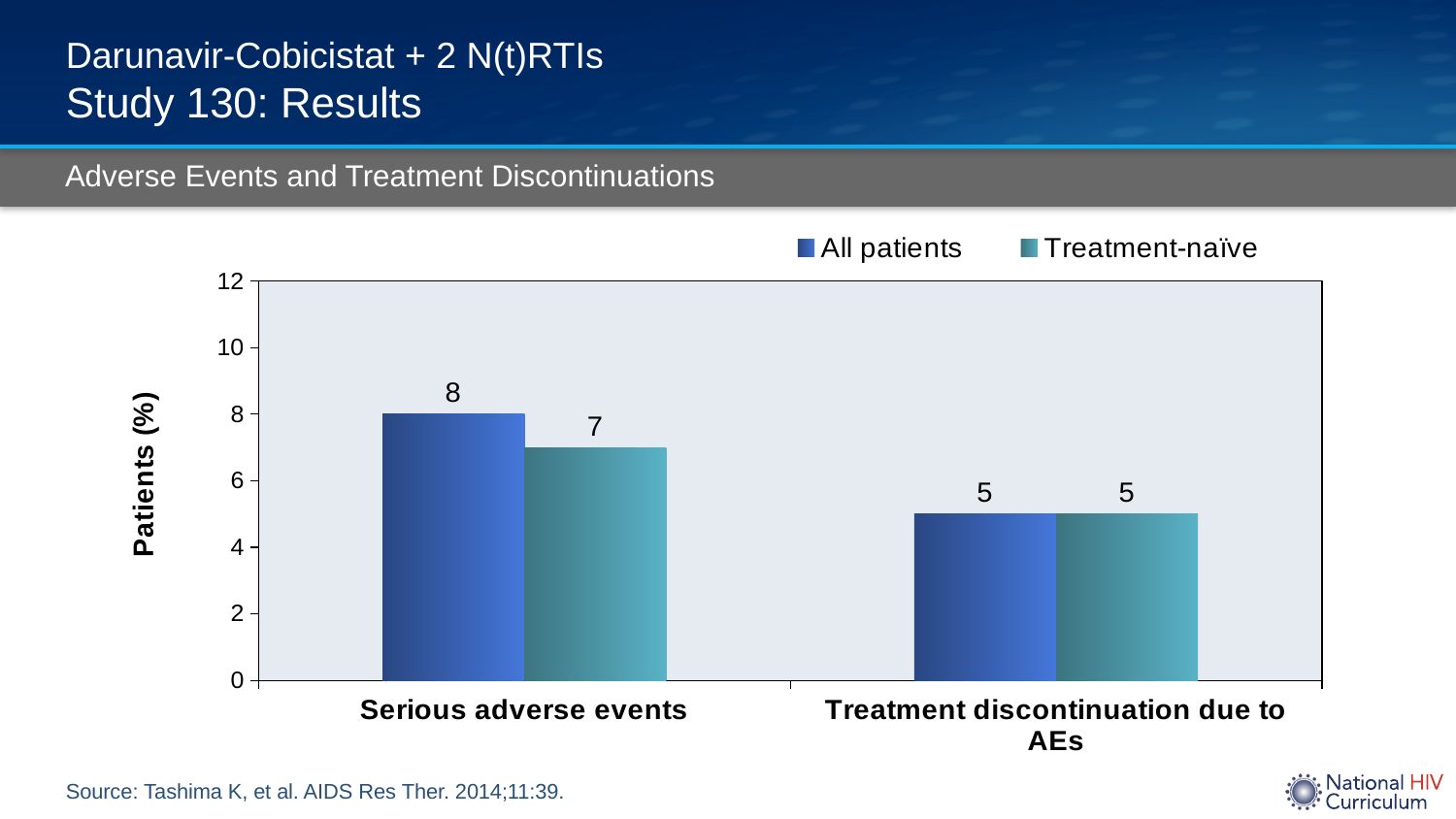
Which category has the lowest value for Treatment-naïve? Treatment discontinuation due to AEs What is the value for Treatment-naïve in the Treatment discontinuation due to AEs category? 5 What is the value for Treatment-naïve in the Serious adverse events category? 7 What kind of chart is shown on the slide? Bar chart For Serious adverse events, which is larger: All patients or Treatment-naïve? All patients What is the value for All patients in the Serious adverse events category? 8 What is the difference between the All patients and Treatment-naïve values for Serious adverse events? 1 How many categories are shown on the x axis? 2 What is the label of the y axis? Patients (%) Which category has the highest value for All patients? Serious adverse events What is the value for All patients in the Treatment discontinuation due to AEs category? 5 How many series does the legend list? 2